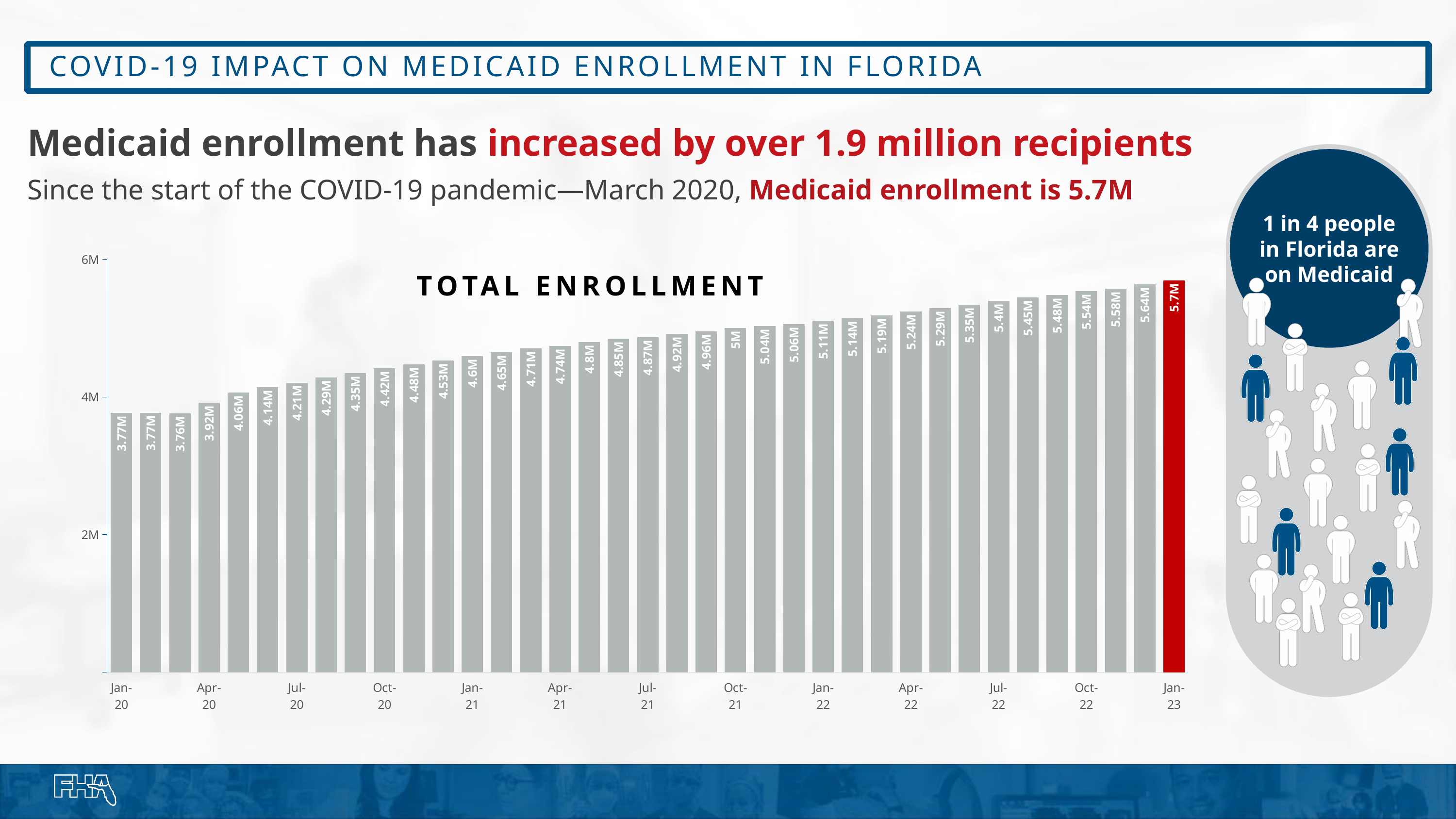
What is the total enrollment value for Jan-21? 4.6M What kind of chart is shown on the slide? Bar chart Do the total enrollment values rise or fall from Jan-20 to Jan-23? Rise What is the difference in total enrollment between Jan-23 and Jan-20? 1.93M What is the total enrollment value for Jan-22? 5.11M Which is larger, the total enrollment for Jan-22 or for Jan-21? Jan-22 How many bars are plotted in the chart? 37 Is the total enrollment value for Jan-20 greater or less than 4M? less What is the total enrollment value for Jan-23? 5.7M What is the total enrollment value for Jan-20? 3.77M Which month has the highest total enrollment? Jan-23 What is the total enrollment value for Oct-21? 5M